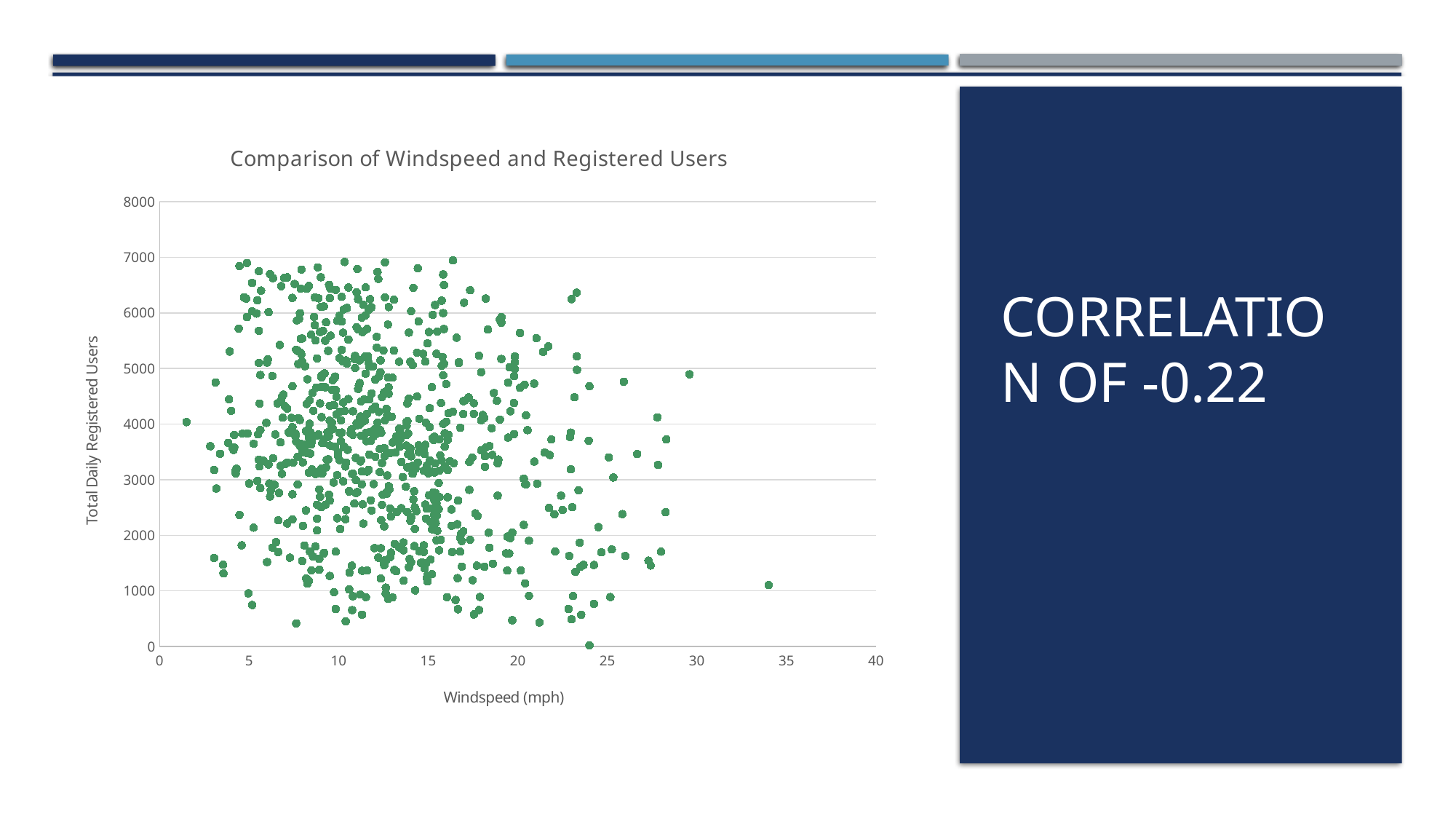
What correlation value does the slide state for the relationship shown in the chart? -0.22 What is the highest value shown on the y axis of the chart? 8000 What is the highest value shown on the x axis of the chart? 40 What is the title of the chart? Comparison of Windspeed and Registered Users What is the label of the x axis of the chart? Windspeed (mph) Is the registered-users value for the point with the highest windspeed (around 34 mph) greater or less than 2000? less Is the registered-users value for the point at roughly 30 mph windspeed greater or less than 4000? greater What kind of chart is shown on the slide? Scatter plot Are there any points plotted with a windspeed greater than 35 mph? No Do the registered-users values tend to rise or fall as windspeed increases along the x axis? fall